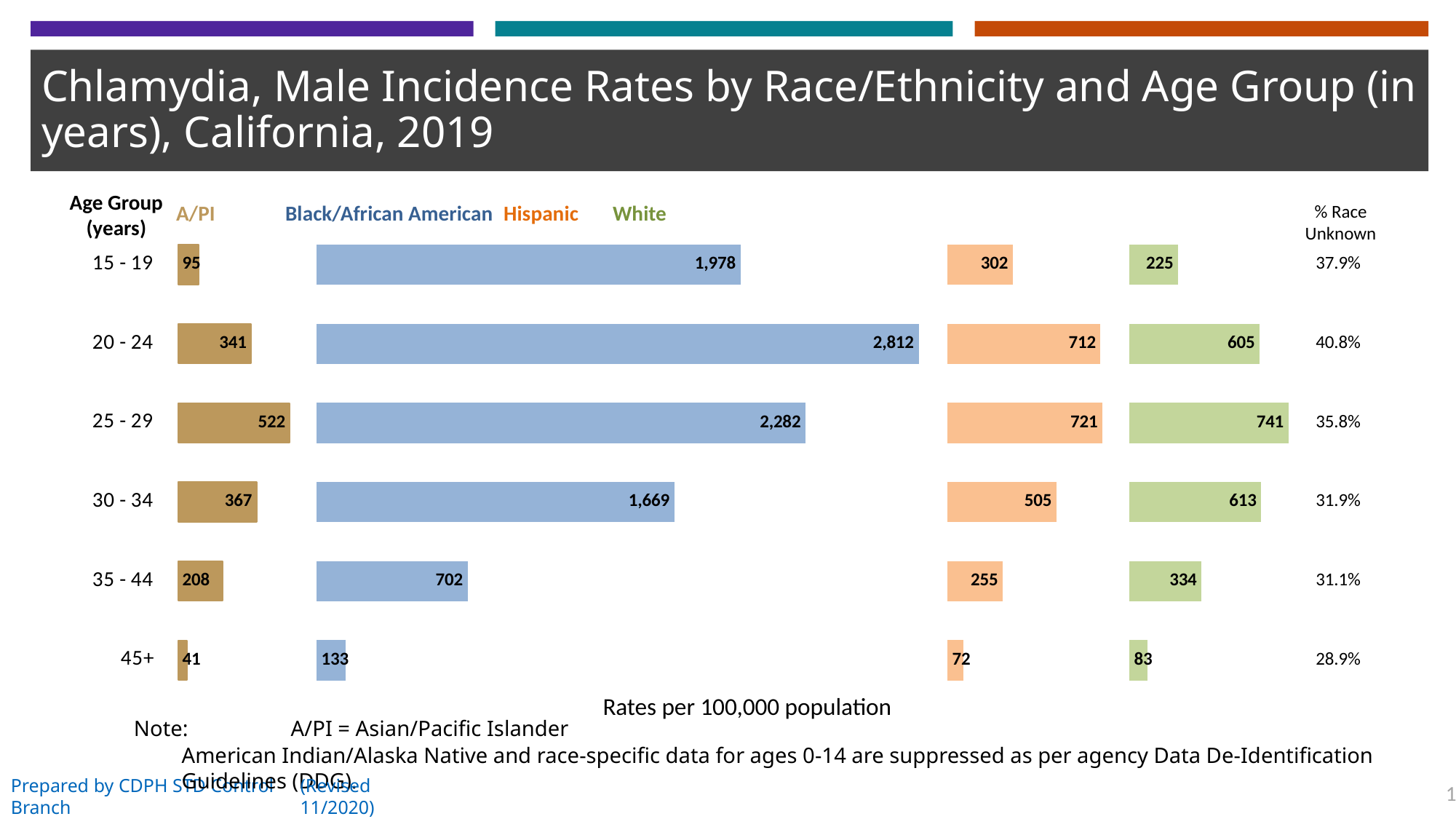
How many age groups are shown in the chart? 6 What is the chlamydia incidence rate for Black/African American males aged 20 - 24? 2,812 For males aged 30 - 34, which is higher: the Hispanic rate or the White rate? White What is the difference between the Black/African American and Hispanic rates for males aged 15 - 19? 1,676 What is the % Race Unknown value for the 20 - 24 age group? 40.8% What kind of chart is shown on the slide? Bar chart What is the chlamydia incidence rate for A/PI males aged 45+? 41 How many race/ethnicity series are shown in the chart? 4 Which age group has the lowest chlamydia incidence rate among White males? 45+ What is the chlamydia incidence rate for Hispanic males aged 25 - 29? 721 Which age group has the highest chlamydia incidence rate among Black/African American males? 20 - 24 What is the chlamydia incidence rate for White males aged 35 - 44? 334